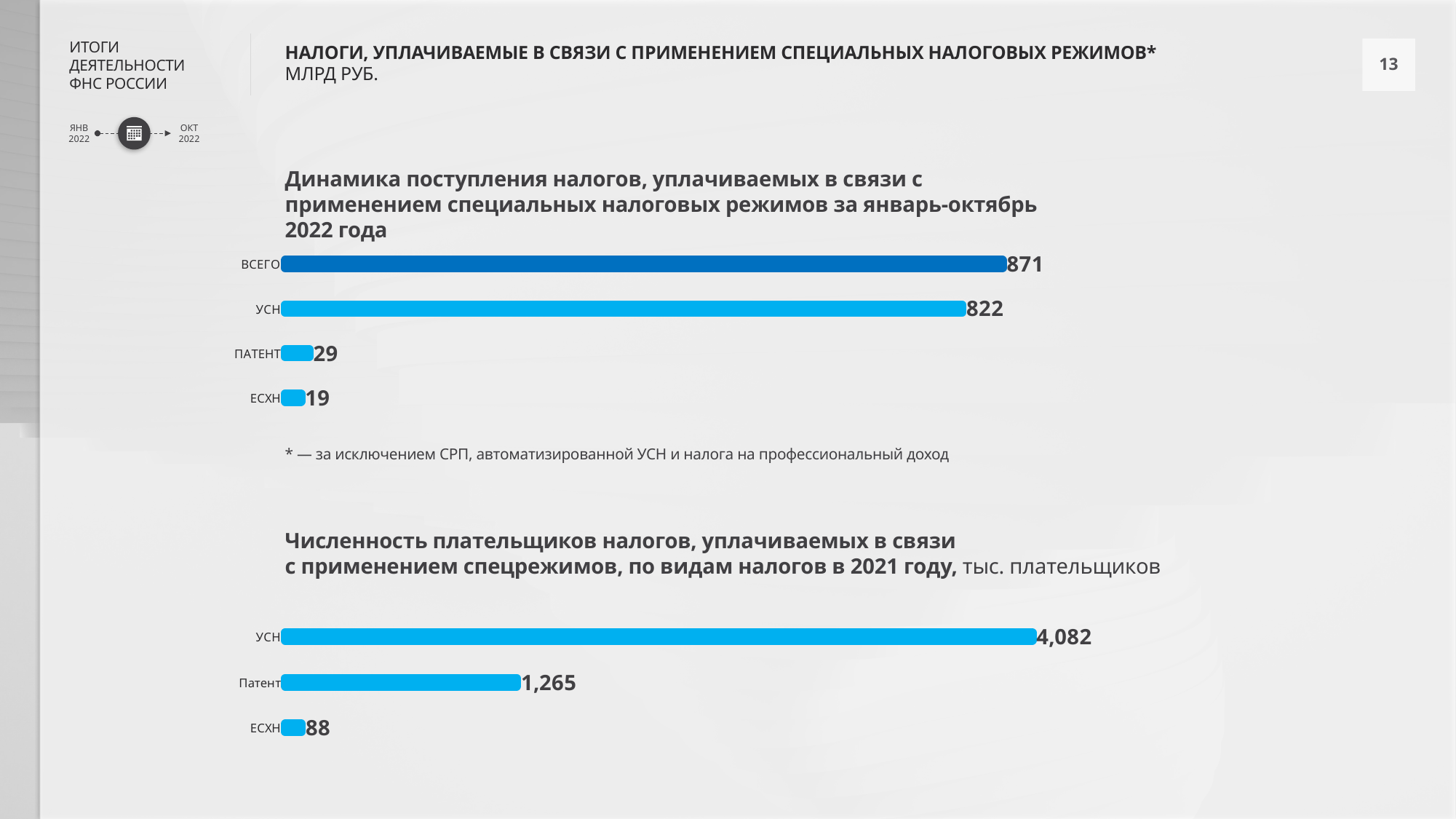
In the top chart (Динамика поступления налогов...), which category has the lowest value? ЕСХН In the top chart (Динамика поступления налогов...), what is the value for УСН? 822 In the bottom chart (Численность плательщиков налогов...), what is the value for УСН? 4,082 In the top chart (Динамика поступления налогов...), what is the value for ВСЕГО? 871 In the top chart (Динамика поступления налогов...), what is the value for ПАТЕНТ? 29 In the bottom chart (Численность плательщиков налогов...), which is larger: Патент or ЕСХН? Патент In the bottom chart (Численность плательщиков налогов...), what is the value for ЕСХН? 88 What type of chart is the bottom chart (Численность плательщиков налогов...)? Bar chart In the bottom chart (Численность плательщиков налогов...), what is the value for Патент? 1,265 In the top chart (Динамика поступления налогов...), what is the difference between ВСЕГО and УСН? 49 In the bottom chart (Численность плательщиков налогов...), which category has the highest value? УСН In the top chart (Динамика поступления налогов...), how many categories are shown? 4